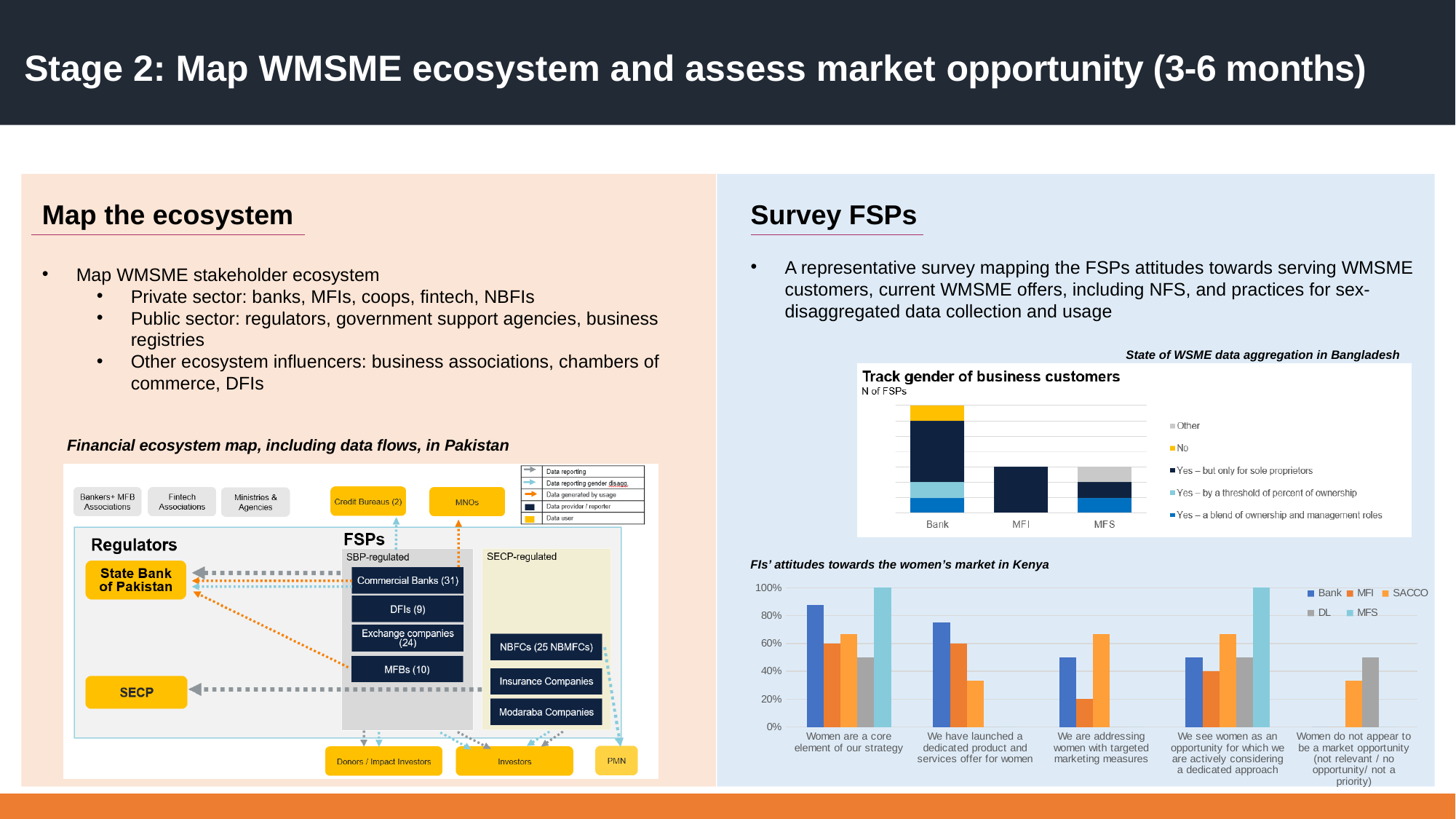
How many entries does the legend of the 'Track gender of business customers' chart list? 5 How many statement categories are shown on the x axis of the 'FIs' attitudes towards the women's market in Kenya' chart? 5 In the 'Track gender of business customers' chart, which category is the only one with a 'No' segment? Bank What type of chart is the 'FIs' attitudes towards the women's market in Kenya' chart? bar chart What type of chart is the 'Track gender of business customers' chart? stacked bar chart How many series does the legend of the 'FIs' attitudes towards the women's market in Kenya' chart list? 5 In the 'FIs' attitudes towards the women's market in Kenya' chart, is the MFI value for 'We are addressing women with targeted marketing measures' greater or less than 40%? less How many categories are shown on the x axis of the 'Track gender of business customers' chart? 3 In the 'FIs' attitudes towards the women's market in Kenya' chart, which series has the highest value for 'Women are a core element of our strategy'? MFS In the 'Track gender of business customers' chart, which category has the tallest stacked bar? Bank In the 'FIs' attitudes towards the women's market in Kenya' chart, is the Bank value for 'Women are a core element of our strategy' greater or less than 80%? greater In the 'FIs' attitudes towards the women's market in Kenya' chart, for 'Women are a core element of our strategy', which is larger: the Bank value or the MFI value? Bank